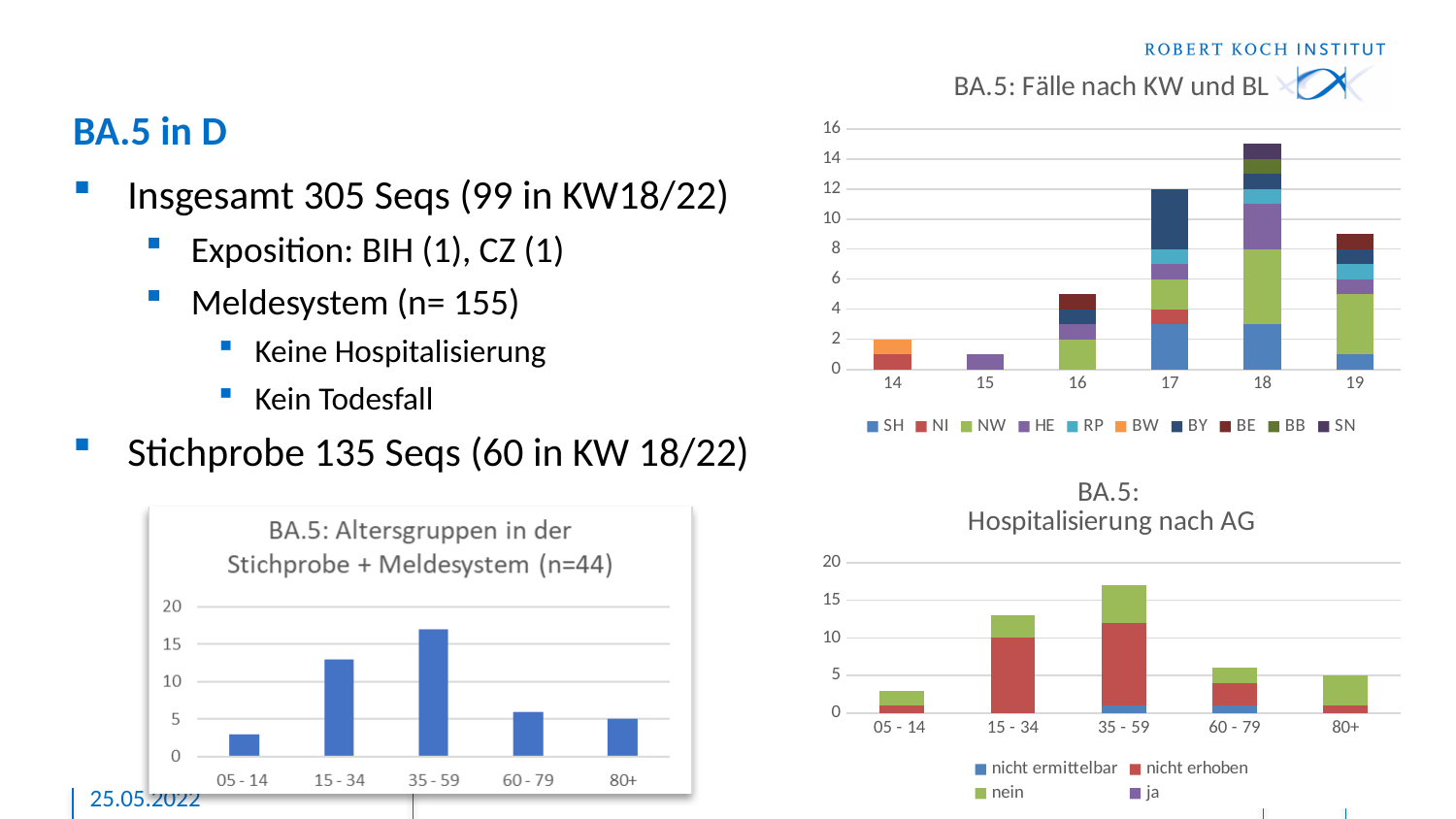
In the chart 'BA.5: Fälle nach KW und BL', is the total for week 19 greater or less than 10? less In the chart 'BA.5: Altersgruppen in der Stichprobe + Meldesystem (n=44)', which is larger, the value for 15 - 34 or the value for 60 - 79? 15 - 34 How many series does the legend of the chart 'BA.5: Fälle nach KW und BL' list? 10 In the chart 'BA.5: Altersgruppen in der Stichprobe + Meldesystem (n=44)', which age group has the lowest value? 05 - 14 How many age groups are shown in the chart 'BA.5: Altersgruppen in der Stichprobe + Meldesystem (n=44)'? 5 In the chart 'BA.5: Hospitalisierung nach AG', which age group has the highest total? 35 - 59 In the chart 'BA.5: Altersgruppen in der Stichprobe + Meldesystem (n=44)', is the value for 05 - 14 greater or less than 5? less What kind of chart is 'BA.5: Hospitalisierung nach AG'? stacked bar chart In the chart 'BA.5: Altersgruppen in der Stichprobe + Meldesystem (n=44)', which age group has the highest value? 35 - 59 In the chart 'BA.5: Fälle nach KW und BL', which calendar week has the highest total? 18 In the chart 'BA.5: Altersgruppen in der Stichprobe + Meldesystem (n=44)', is the value for 35 - 59 greater or less than 15? greater In the chart 'BA.5: Fälle nach KW und BL', which calendar week has the lowest total? 15